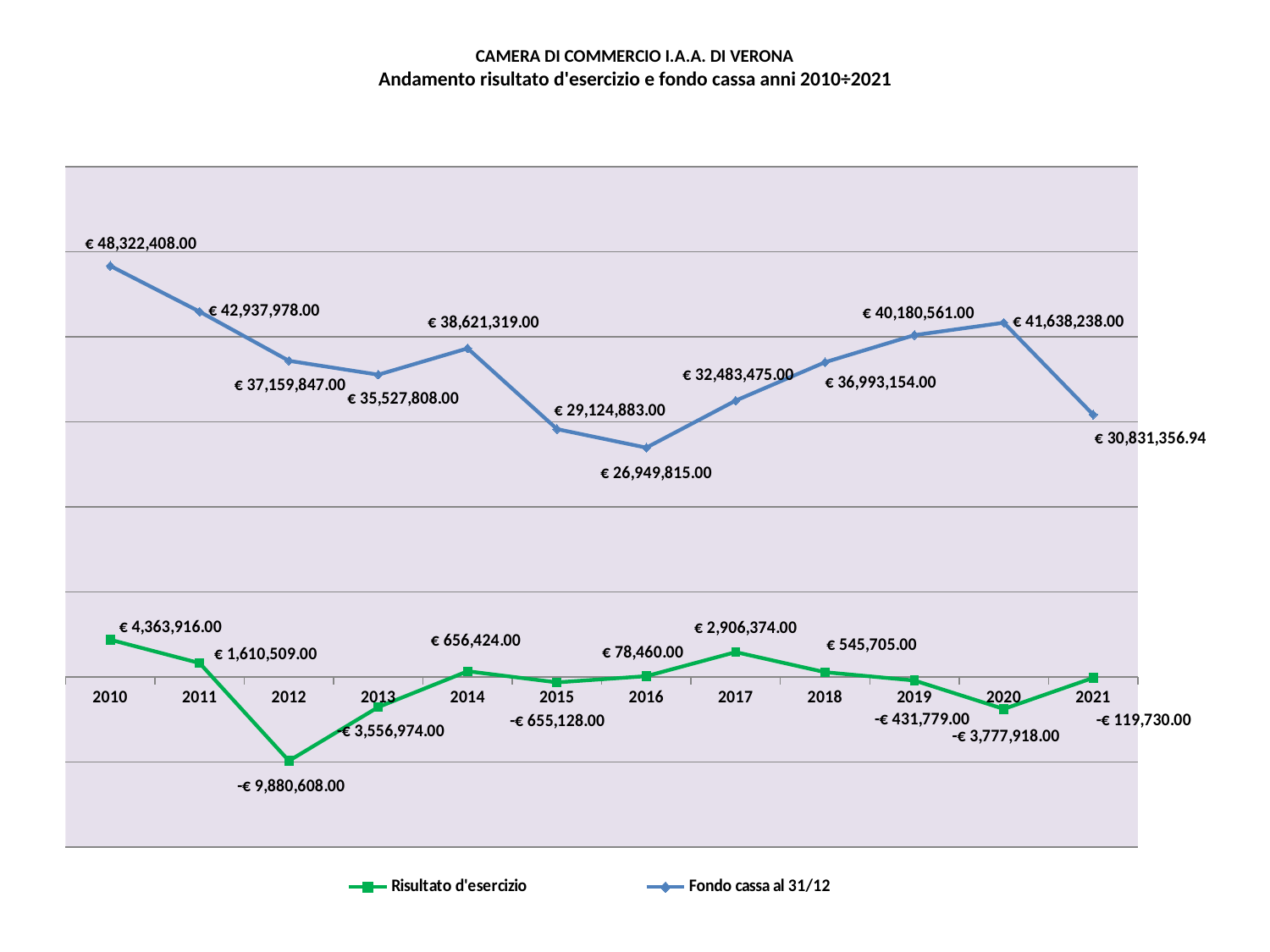
What kind of chart is shown on the slide? Line chart What is the value of Fondo cassa al 31/12 for 2010? € 48,322,408.00 What is the Risultato d'esercizio for 2017? € 2,906,374.00 How many series does the legend list? 2 What is the value of Fondo cassa al 31/12 for 2021? € 30,831,356.94 In which year is Fondo cassa al 31/12 lowest? 2016 What is the difference between Fondo cassa al 31/12 in 2010 and in 2011? € 5,384,430.00 What is the Risultato d'esercizio for 2012? -€ 9,880,608.00 In which year is the Risultato d'esercizio lowest? 2012 In which year is Fondo cassa al 31/12 highest? 2010 How many years are shown on the x axis? 12 Which year has a higher Fondo cassa al 31/12, 2014 or 2015? 2014